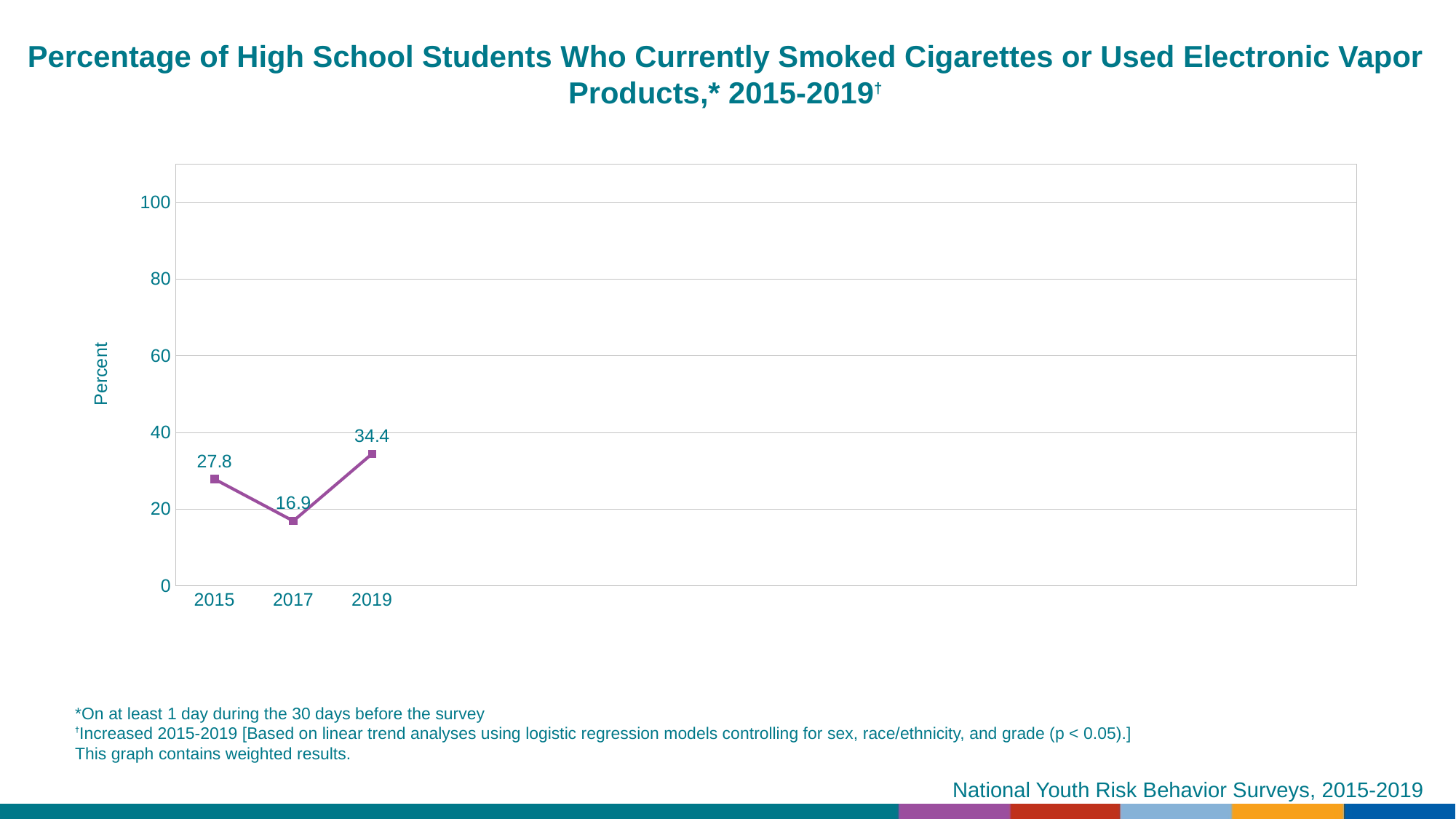
What is the value for 2015? 27.8 What is the difference between the values for 2019 and 2015? 6.6 What is the difference between the values for 2015 and 2017? 10.9 Which year has the lowest value? 2017 What is the label of the y axis? Percent What is the value for 2019? 34.4 What kind of chart is shown on the slide? line chart Is the value for 2019 greater or less than 40? less Which is larger, the value for 2015 or the value for 2017? 2015 Which year has the highest value? 2019 How many years are plotted on the chart? 3 What is the value for 2017? 16.9